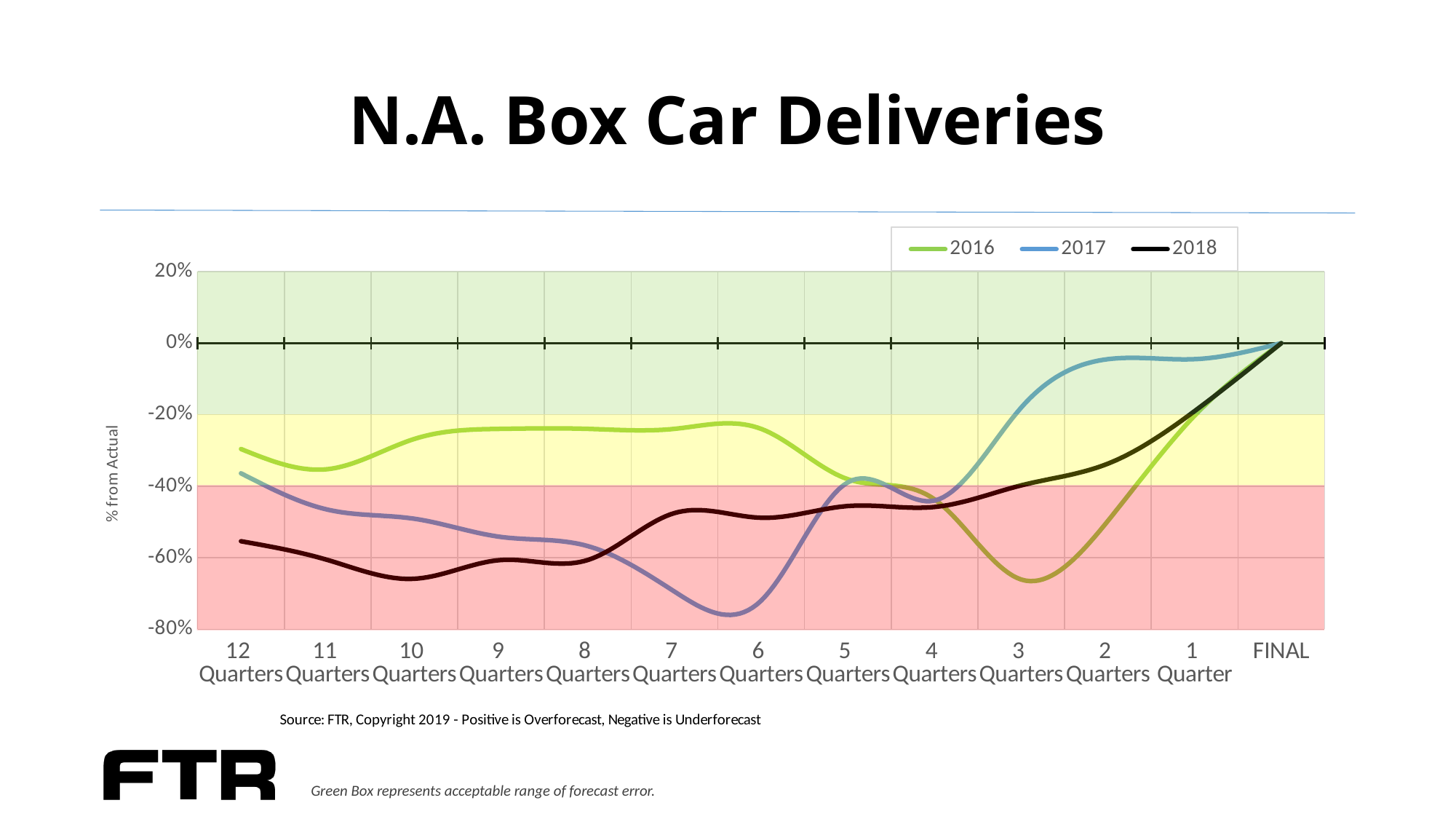
Is the value for 2018 at 12 Quarters greater or less than -40%? less At 12 Quarters, which series has the highest value? 2016 What kind of chart is shown on the slide? line chart At 2 Quarters, which is larger, the value for 2017 or the value for 2016? 2017 Is the value for 2016 at 12 Quarters greater or less than -40%? greater At 6 Quarters, which series has the lowest value? 2017 What is the value of the 2018 series at FINAL? 0% How many points are there along the x axis, from 12 Quarters to FINAL? 13 Is the value for 2017 at 2 Quarters greater or less than -20%? greater How many series does the legend list? 3 Does the 2018 series rise or fall from 4 Quarters to FINAL? rise